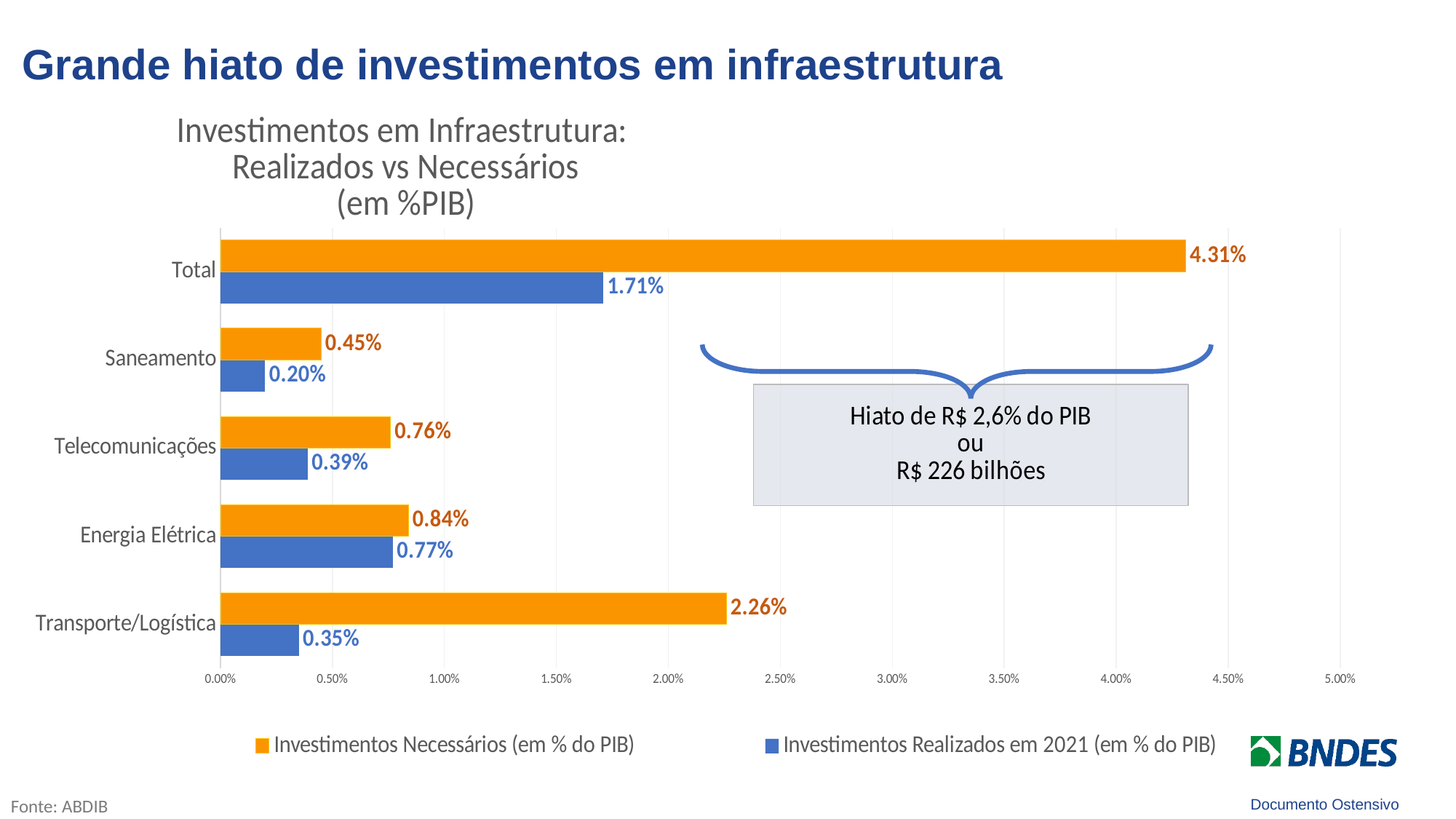
How many series does the legend list? 2 Excluding Total, which category has the highest value for Investimentos Necessários (em % do PIB)? Transporte/Logística Excluding Total, which category has the lowest value for Investimentos Realizados em 2021 (em % do PIB)? Saneamento Which is larger: Investimentos Realizados em 2021 for Energia Elétrica or for Transporte/Logística? Energia Elétrica What is the value of Investimentos Realizados em 2021 (em % do PIB) for Total? 1.71% Is the value of Investimentos Necessários for Total greater or less than 4.00%? greater How many categories are shown on the y axis of the chart? 5 What kind of chart is shown on the slide? Bar chart What is the value of Investimentos Realizados em 2021 (em % do PIB) for Saneamento? 0.20% What is the difference between Investimentos Necessários and Investimentos Realizados em 2021 for Telecomunicações? 0.37% What is the value of Investimentos Necessários (em % do PIB) for Transporte/Logística? 2.26% What is the difference between Investimentos Necessários and Investimentos Realizados em 2021 for Total? 2.60%